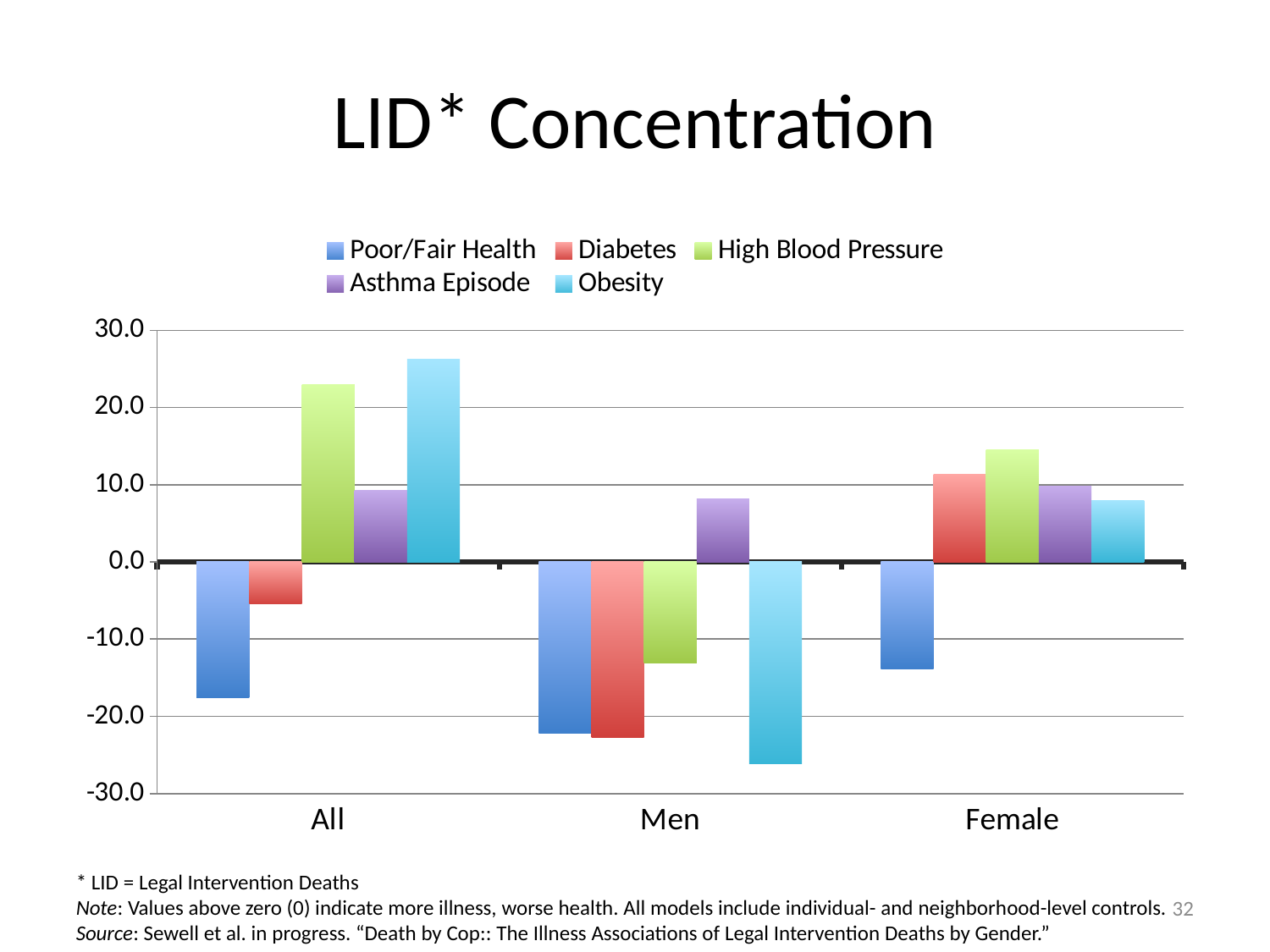
What is the title of the chart? LID* Concentration Which series has the lowest value in the Men category? Obesity Is the value for Obesity in the All category greater or less than 20.0? greater What kind of chart is shown on the slide? bar chart Is the value for Poor/Fair Health in the Men category greater or less than -20.0? less How many series does the legend list? 5 Which series is shown in green? High Blood Pressure How many categories are shown on the x axis? 3 Which series has the highest value in the All category? Obesity In the Female category, which is larger: Diabetes or High Blood Pressure? High Blood Pressure In the All category, which is larger: Poor/Fair Health or Diabetes? Diabetes Is the value for High Blood Pressure in the Female category greater or less than 10.0? greater